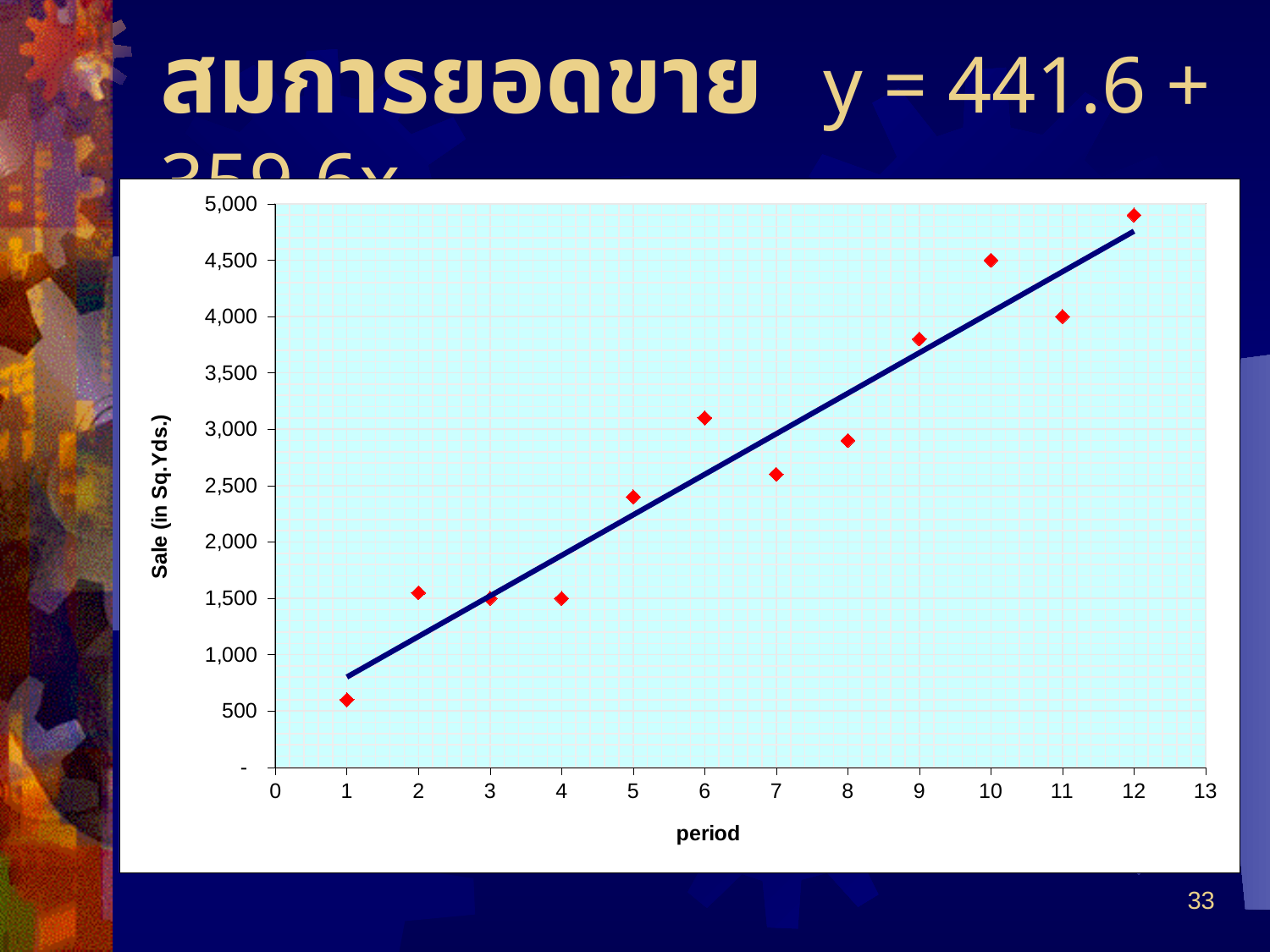
Is the sale value for period 9 greater or less than 4,000? less Which has the larger sale value, period 6 or period 7? period 6 Which period has the lowest sale value? 1 Is the sale value for period 6 greater or less than 3,000? greater What kind of chart is shown on the slide? scatter chart What is the label of the vertical axis? Sale (in Sq.Yds.) Is the sale value for period 1 greater or less than 1,000? less Which has the larger sale value, period 10 or period 11? period 10 Which period has the highest sale value? 12 Do the sale values generally rise or fall as the period increases? rise How many data points are plotted on the chart? 12